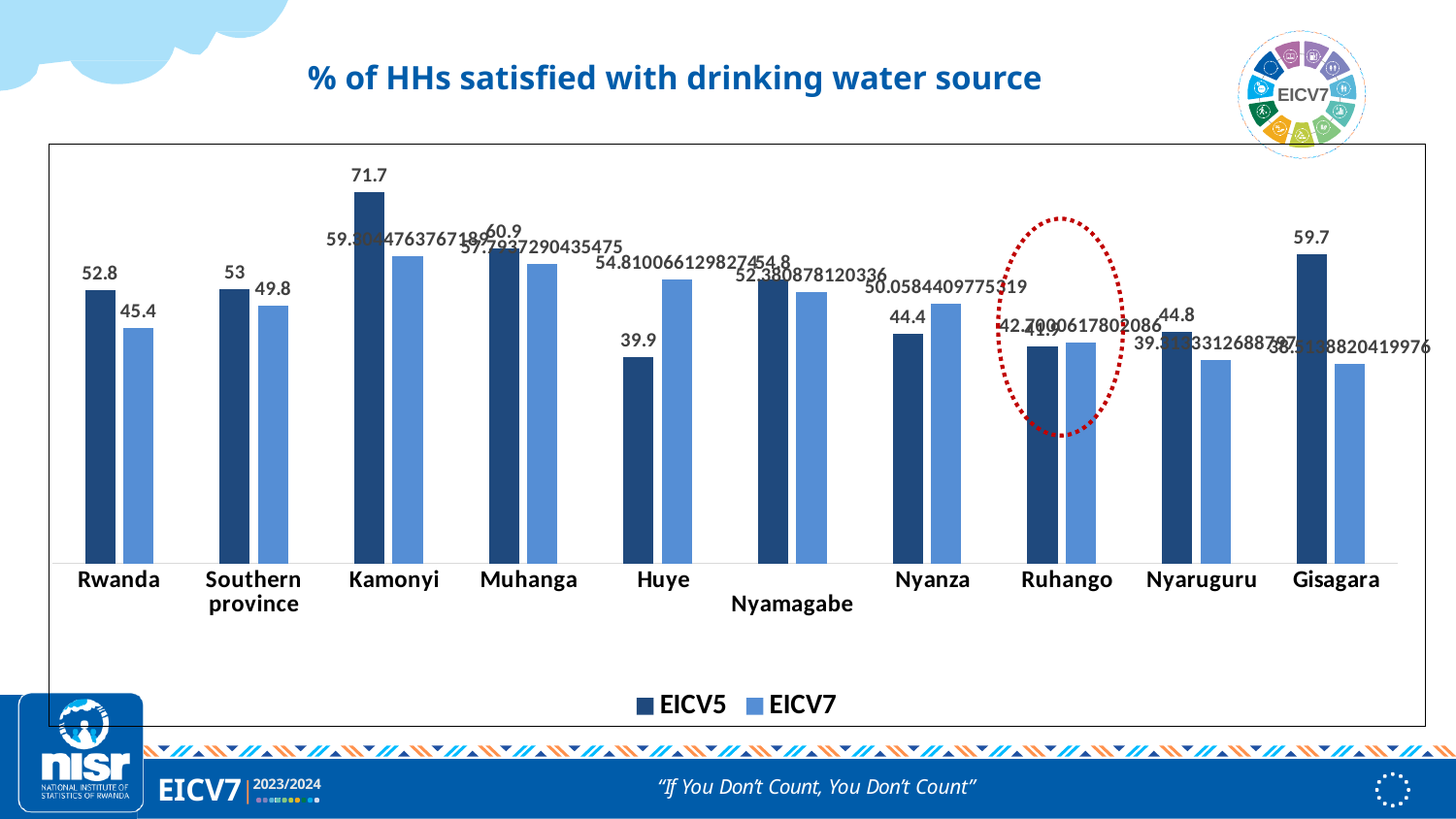
What is the EICV7 value for Rwanda? 45.4 How many categories are shown on the x axis? 10 What kind of chart is shown on the slide? Bar chart What is the EICV5 value for Gisagara? 59.7 Which category has the highest EICV5 value? Kamonyi What is the EICV5 value for Rwanda? 52.8 How many series does the legend list? 2 Which category has the lowest EICV5 value? Huye What is the EICV7 value for Southern province? 49.8 What is the EICV5 value for Huye? 39.9 For Gisagara, which is larger, the EICV5 value or the EICV7 value? EICV5 What is the difference between the EICV5 and EICV7 values for Rwanda? 7.4